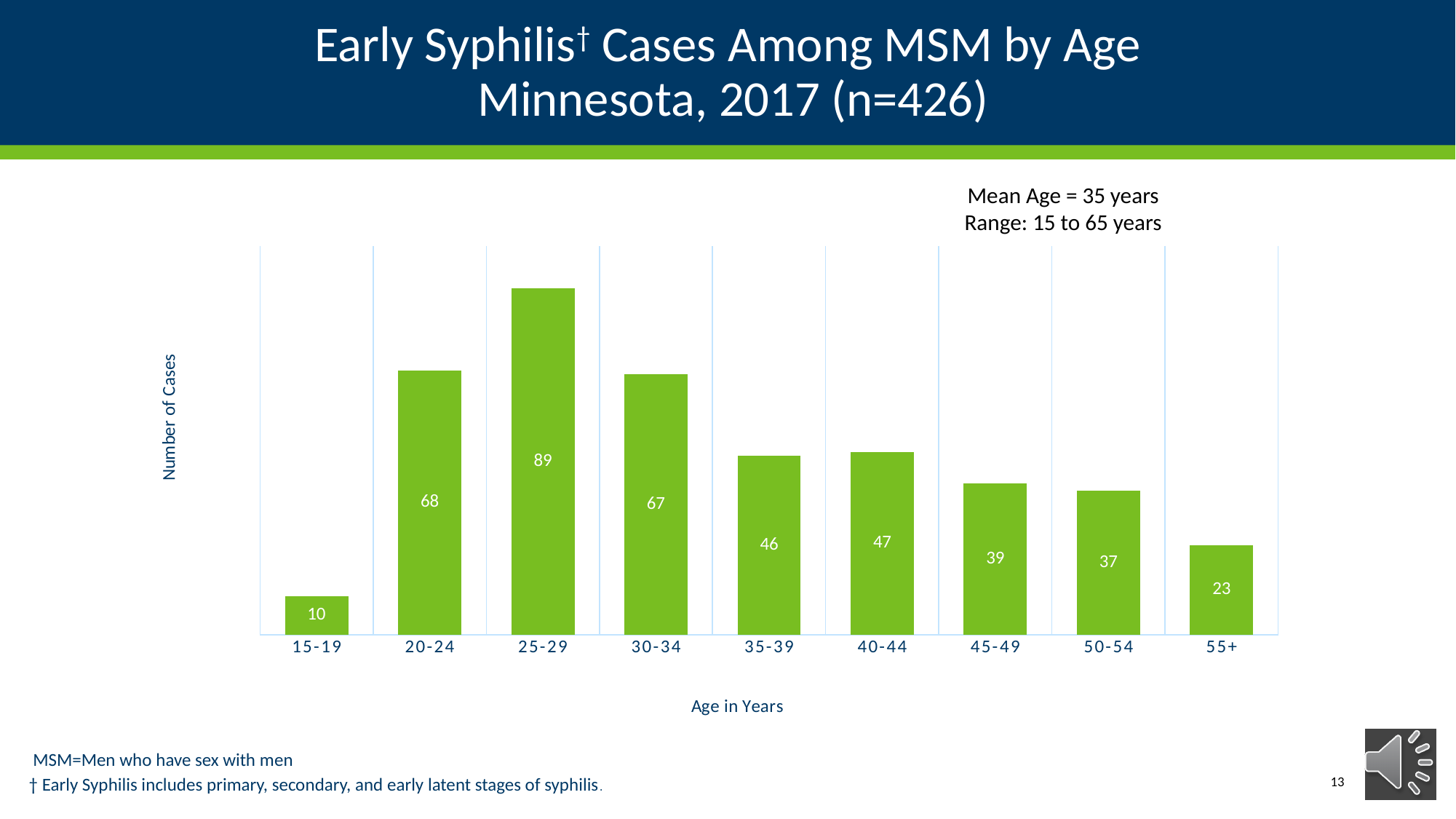
Which age group has the highest number of cases? 25-29 Which age group has more cases, 35-39 or 45-49? 35-39 How many cases are shown for the 55+ age group? 23 Do the number of cases rise or fall from the 30-34 age group to the 55+ age group? Fall What is the difference in cases between the 20-24 and 55+ age groups? 45 What kind of chart is shown on the slide? Bar chart What is the difference in cases between the 25-29 and 30-34 age groups? 22 What is the label of the x axis? Age in Years Which age group has the lowest number of cases? 15-19 How many early syphilis cases among MSM were in the 25-29 age group? 89 How many age groups are shown on the x axis? 9 What is the number of cases for the 15-19 age group? 10